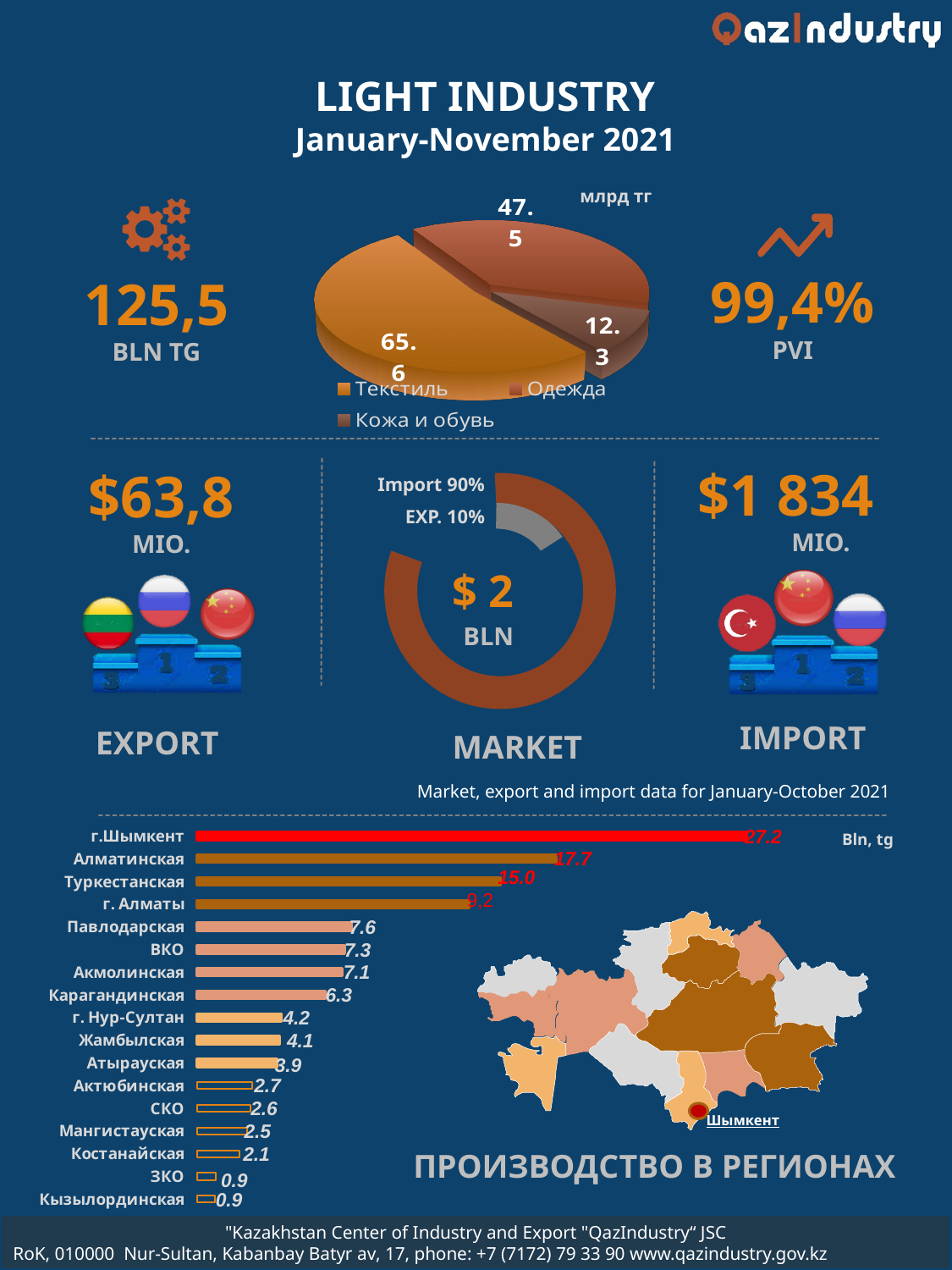
What kind of chart is the ПРОИЗВОДСТВО В РЕГИОНАХ chart at the bottom of the slide? bar chart In the pie chart at the top of the slide, what is the value for Текстиль? 65.6 In the pie chart at the top of the slide, what is the value for Кожа и обувь? 12.3 In the bar chart at the bottom of the slide, what is the value for Алматинская? 17.7 In the bar chart at the bottom of the slide, what is the difference between the values for г.Шымкент and Туркестанская? 12.2 In the MARKET donut chart, what share is labelled as Import? 90% How many regions are shown in the bar chart at the bottom of the slide? 17 How many categories does the legend of the pie chart at the top of the slide list? 3 In the pie chart at the top of the slide, what is the difference between the values for Текстиль and Одежда? 18.1 In the MARKET donut chart, which is larger, Import or EXP.? Import In the bar chart at the bottom of the slide, which region has the highest value? г.Шымкент In the pie chart at the top of the slide, which category has the largest value? Текстиль